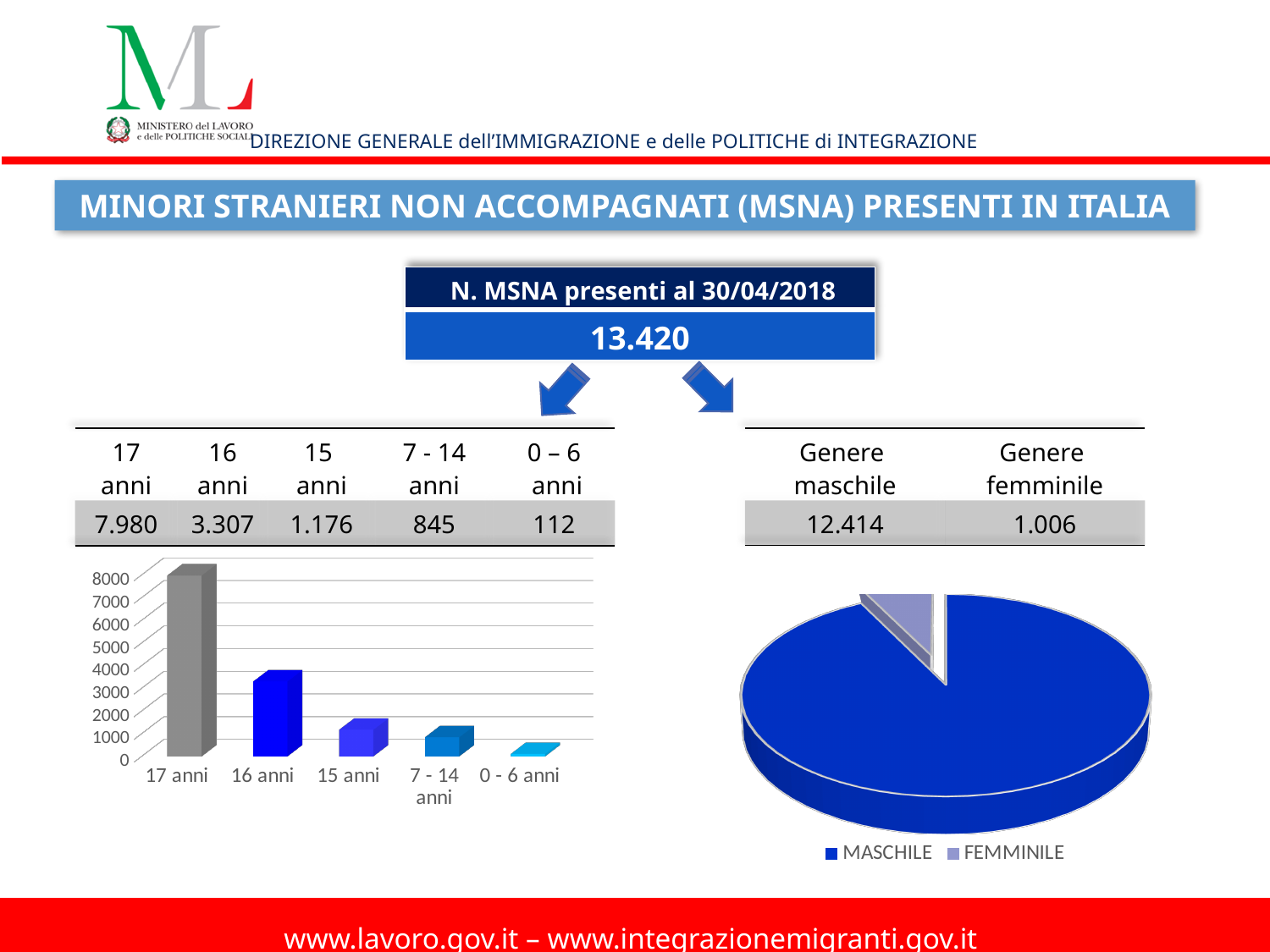
On the bar chart on the left, how many age categories are shown? 5 On the bar chart on the left, what is the value for 17 anni? 7.980 On the bar chart on the left, what is the value for 7 - 14 anni? 845 On the bar chart on the left, do the values rise or fall from 17 anni to 0 - 6 anni? fall On the pie chart on the right, which is larger, MASCHILE or FEMMINILE? MASCHILE How many entries does the legend of the pie chart on the right list? 2 On the pie chart on the right, what is the value for Genere femminile? 1.006 On the bar chart on the left, is the value for 16 anni greater or less than 3000? greater On the bar chart on the left, which age group has the highest value? 17 anni What kind of chart is shown on the left of the slide? bar chart On the bar chart on the left, what is the difference between the values for 16 anni and 15 anni? 2.131 On the bar chart on the left, which age group has the lowest value? 0 - 6 anni